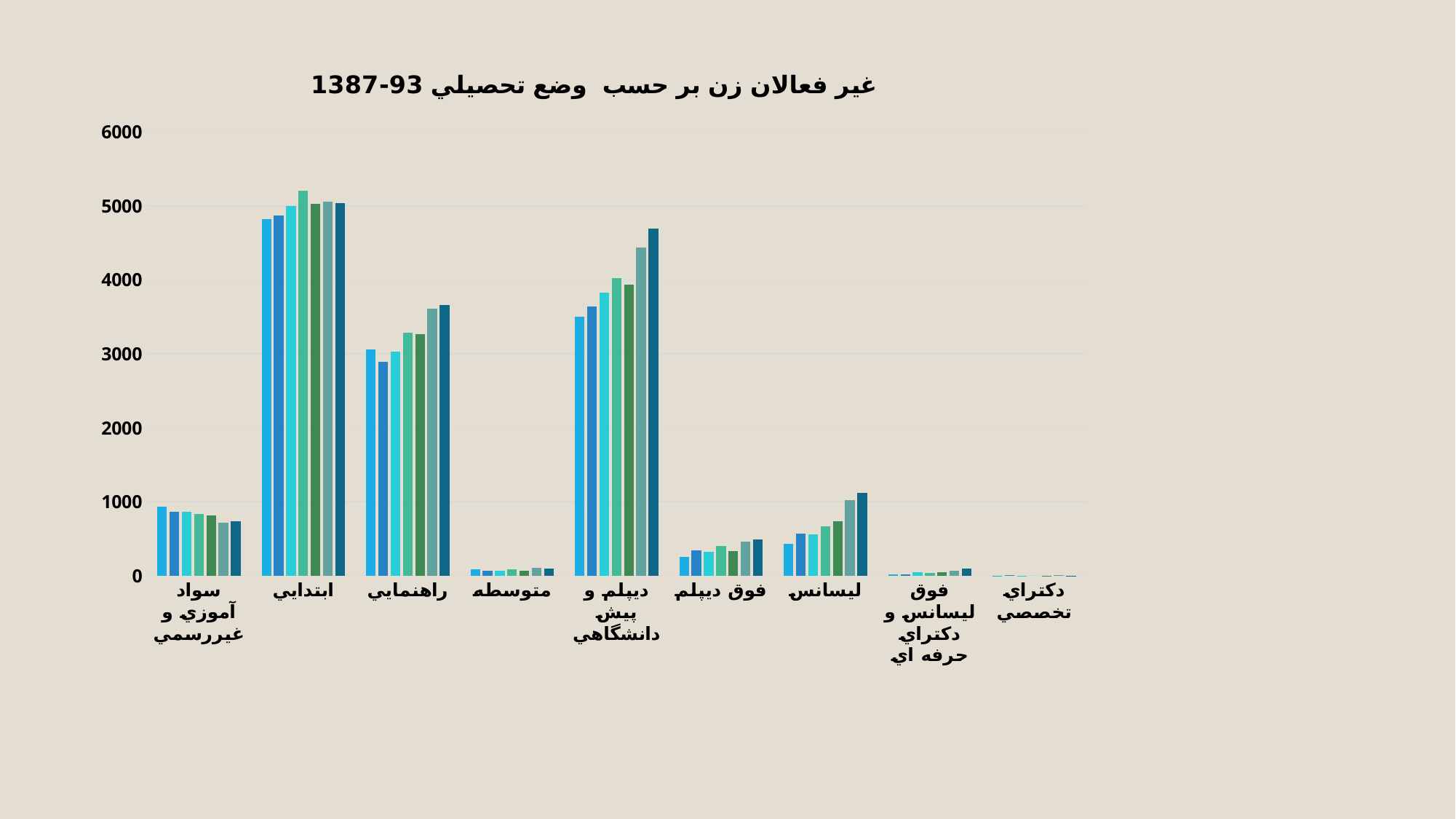
Are the values for متوسطه greater or less than 1000? less How many educational-status categories are shown on the x axis? 9 What is the title of the chart? غير فعالان زن بر حسب وضع تحصيلي 1387-93 Are the values for ليسانس greater or less than 2000? less Which category has higher values, راهنمايي or ليسانس? راهنمايي What kind of chart is shown on the slide? bar chart How many bars are plotted for each category? 7 Which category has the tallest bars? ابتدايي Which category has the shortest bars? دكتراي تخصصي Within the ليسانس category, do the bars rise or fall from left to right? rise Which category has higher values, ابتدايي or ديپلم و پيش دانشگاهي? ابتدايي Are the values for ابتدايي greater or less than 4000? greater